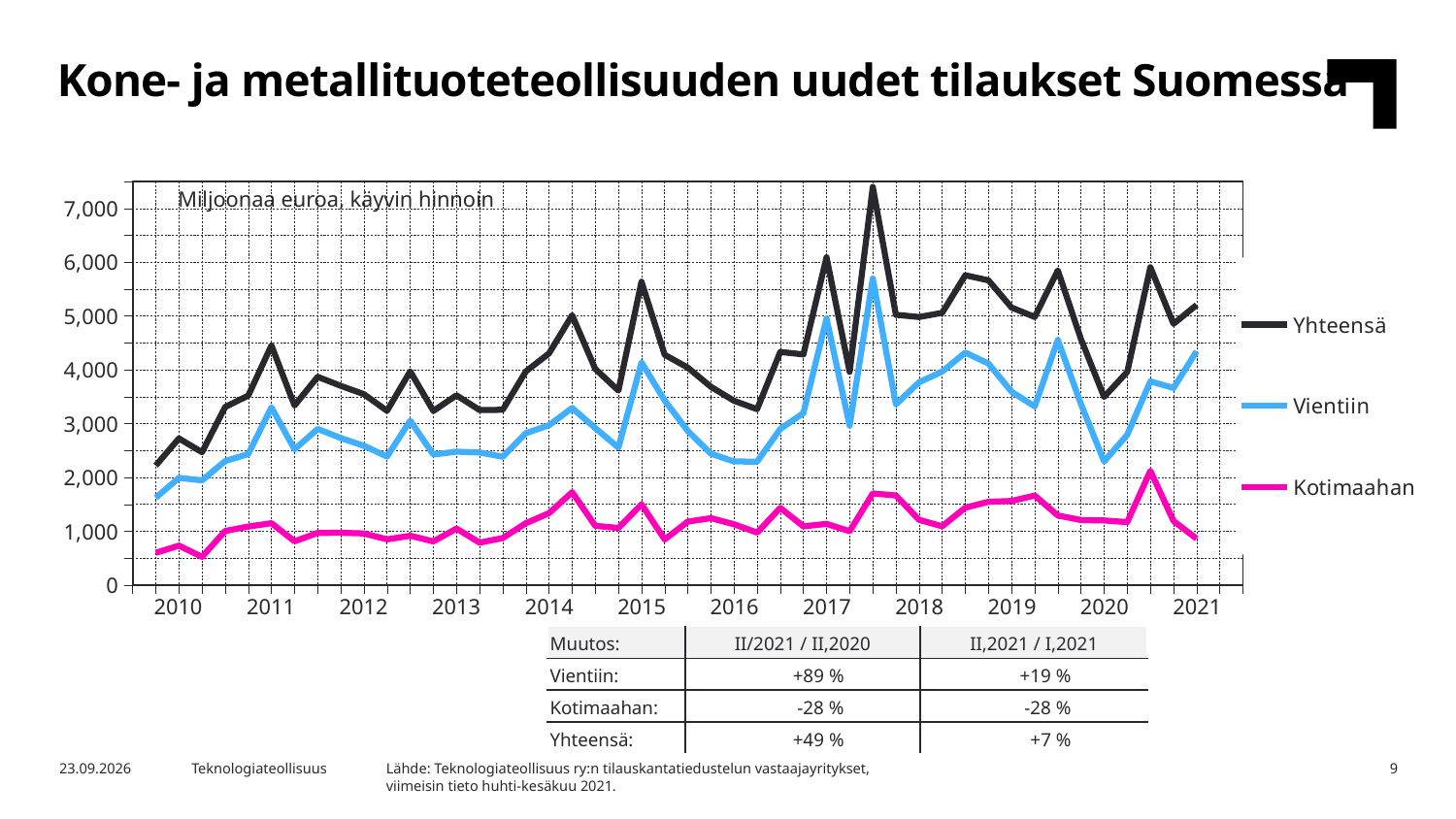
Is the highest value of the Yhteensä series greater or less than 7,000? greater What are the three series named in the chart legend? Yhteensä, Vientiin, Kotimaahan In which year does the Kotimaahan series reach its highest peak? 2020 How many series does the chart legend list? 3 What unit label is printed inside the chart area? Miljoonaa euroa, käyvin hinnoin In which year does the Yhteensä series reach its highest peak? 2017 Which series has the lowest values throughout the chart? Kotimaahan Is the first Vientiin value in 2010 greater or less than 2,000? less What kind of chart is shown on the slide? line chart How many year labels are shown on the x axis? 12 Is the highest value of the Kotimaahan series greater or less than 3,000? less Which series has the highest values throughout the chart? Yhteensä